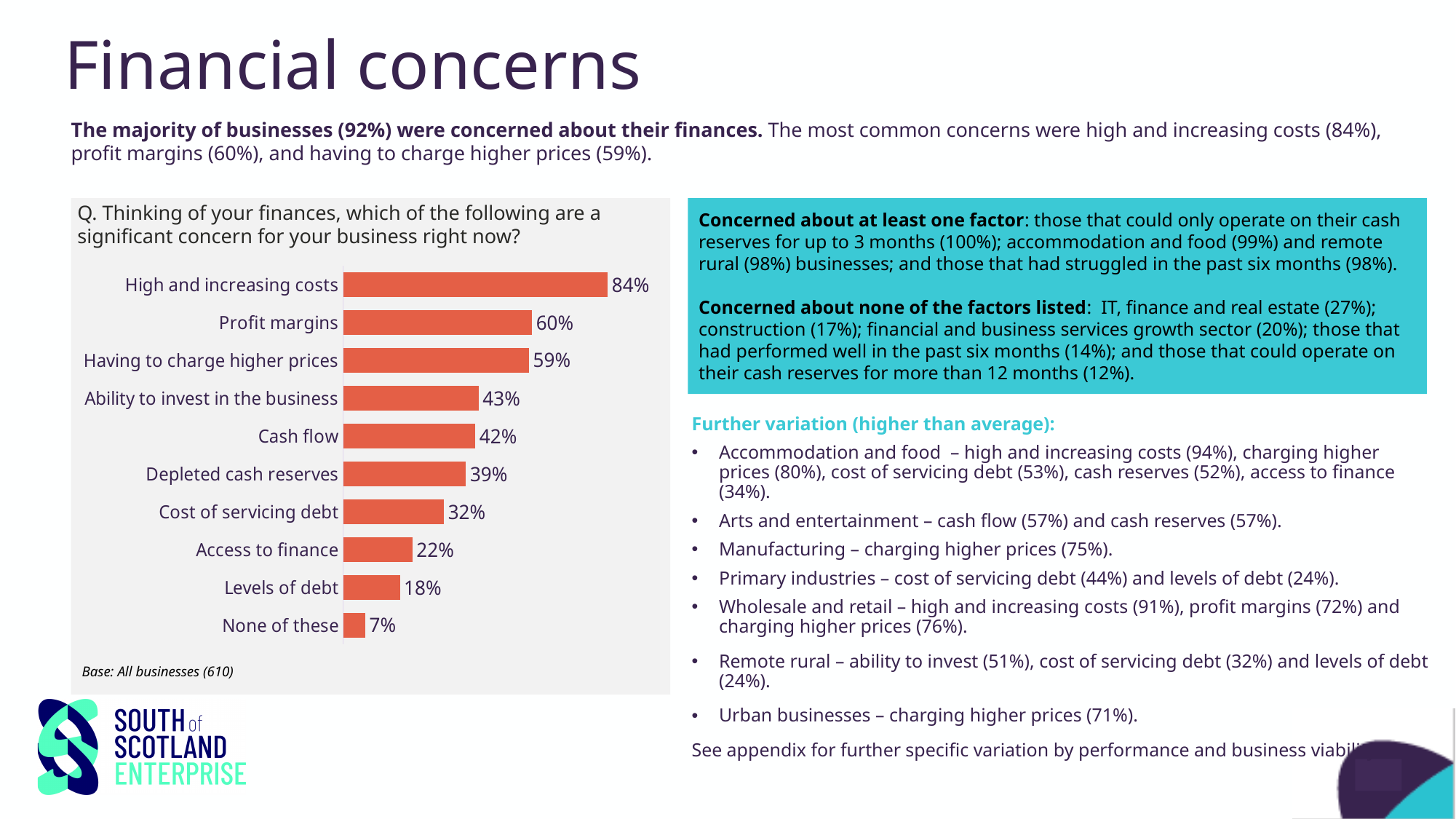
What type of chart is used on the slide? Bar chart What is the value shown for Cash flow? 42% What percentage of businesses selected None of these? 7% Which category has the lowest percentage in the chart? None of these What percentage of businesses cited high and increasing costs as a significant concern? 84% What is the value shown for Ability to invest in the business? 43% What is the difference in percentage points between Profit margins and Having to charge higher prices? 1 Which concern has the highest percentage in the chart? High and increasing costs Which is larger: the value for Access to finance or the value for Levels of debt? Access to finance What is the difference in percentage points between Depleted cash reserves and Cost of servicing debt? 7 How many categories are shown in the bar chart? 10 What is the base (number of businesses) noted beneath the chart? All businesses (610)